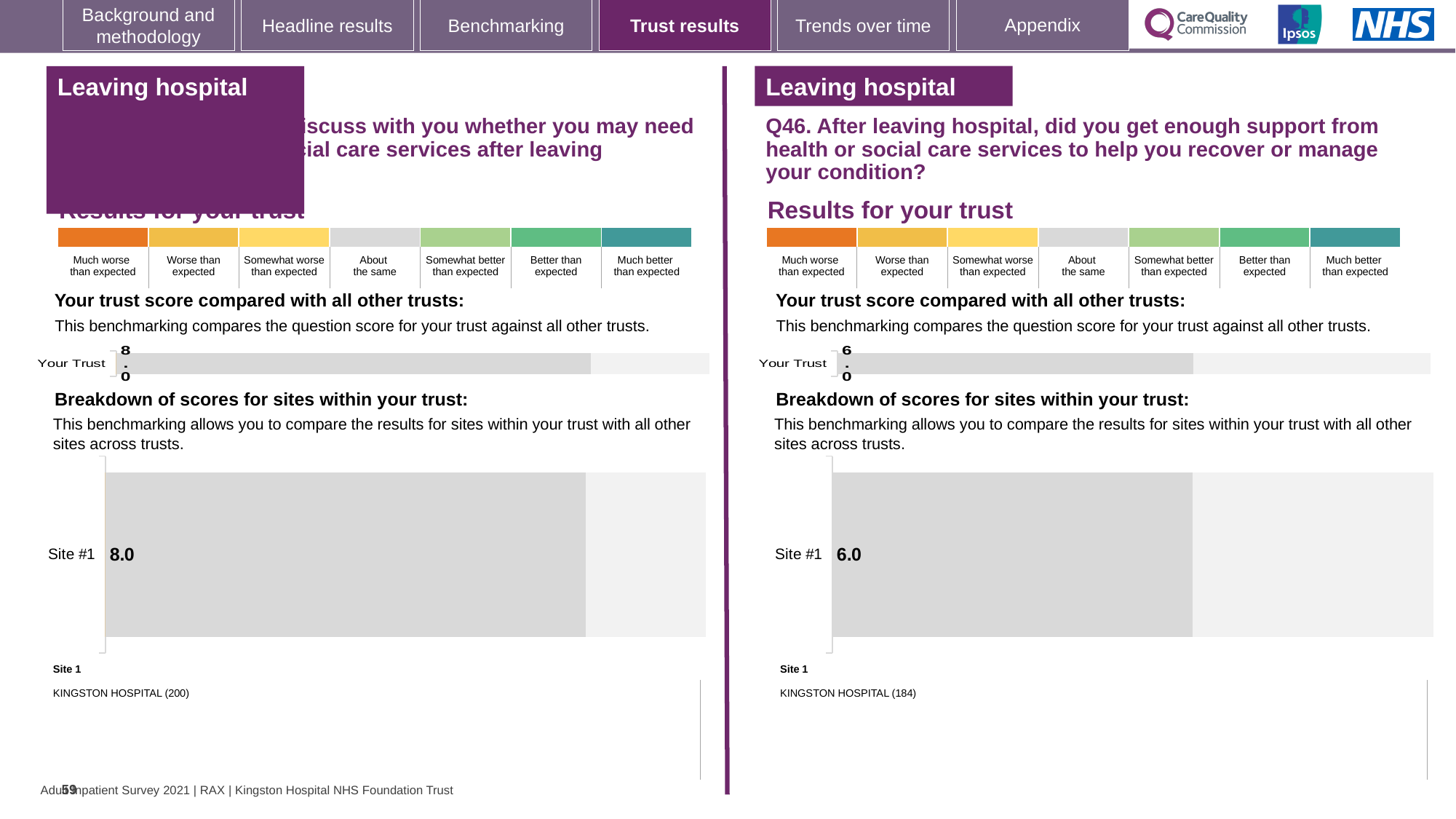
On the right-hand chart (Q46), what is the score shown for Site #1? 6.0 On the left-hand chart, what is the score shown for Site #1? 8.0 On the left-hand chart, which site is listed as Site 1? KINGSTON HOSPITAL (200) On the right-hand chart (Q46), which site is listed as Site 1? KINGSTON HOSPITAL (184) On the right-hand chart (Q46), what is the 'Your Trust' score? 6.0 Which is larger: the Site #1 score on the left-hand chart or the Site #1 score on the right-hand chart (Q46)? Left-hand chart (8.0) What is the difference between the Site #1 score on the left-hand chart and the Site #1 score on the right-hand chart (Q46)? 2.0 On the left-hand chart, what is the 'Your Trust' score? 8.0 Is the Site #1 score on the right-hand chart (Q46) greater or less than 8? less How many sites are shown in the site breakdown chart on the right-hand side (Q46)? 1 What type of chart is used for the site breakdown on the left-hand side? Bar chart